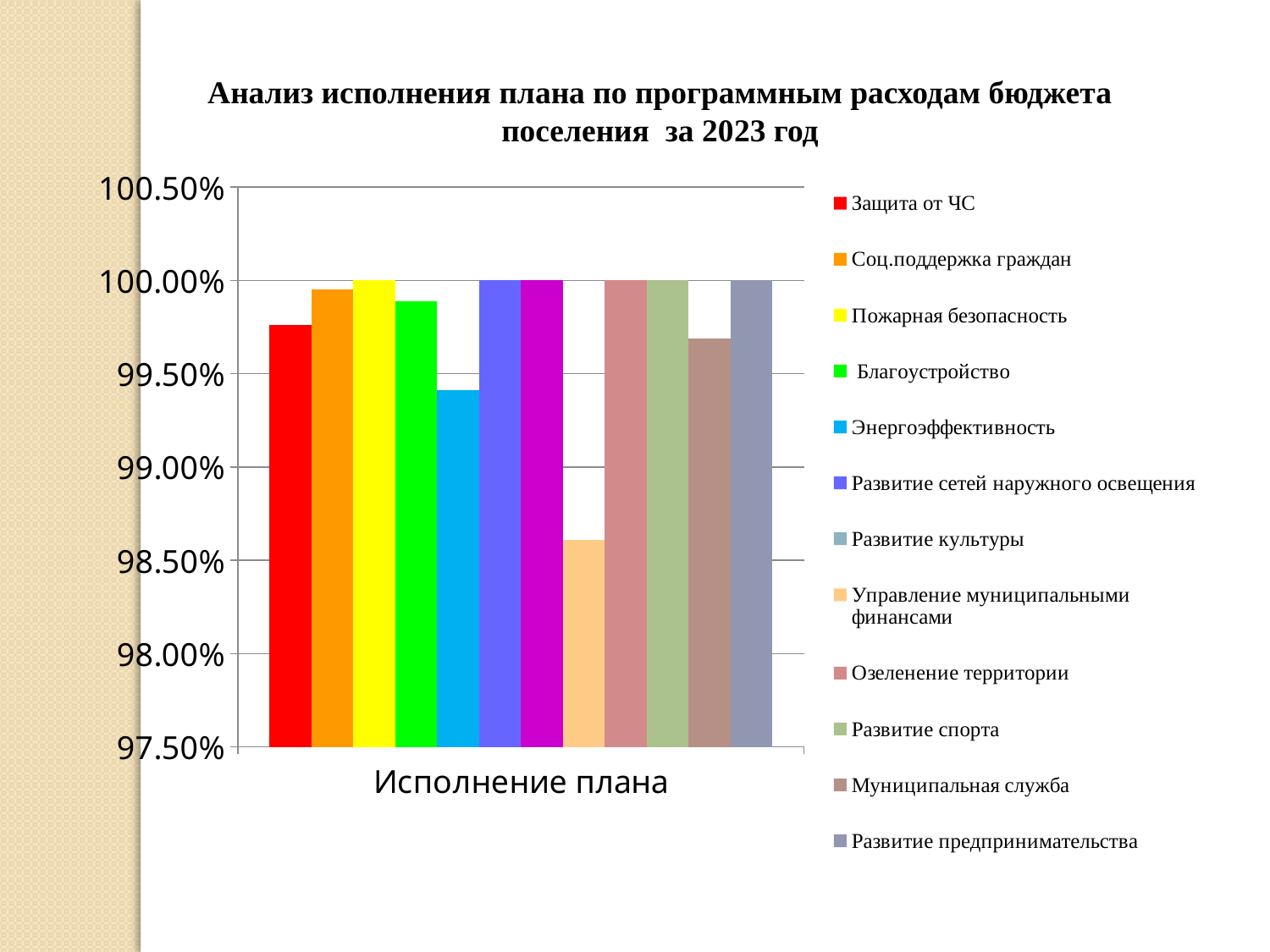
How many series does the legend list? 12 What is the value for Развитие спорта? 100.00% Is the value for Энергоэффективность greater or less than 99.50%? less Which is larger, the value for Соц.поддержка граждан or the value for Защита от ЧС? Соц.поддержка граждан How many categories are shown on the x axis? 1 Is the value for Муниципальная служба greater or less than 99.50%? greater Which is larger, the value for Благоустройство or the value for Энергоэффективность? Благоустройство Is the value for Управление муниципальными финансами greater or less than 98.50%? greater What kind of chart is shown on the slide? bar chart What is the value for Пожарная безопасность? 100.00% Which series has the lowest value? Управление муниципальными финансами What is the category label on the x axis? Исполнение плана